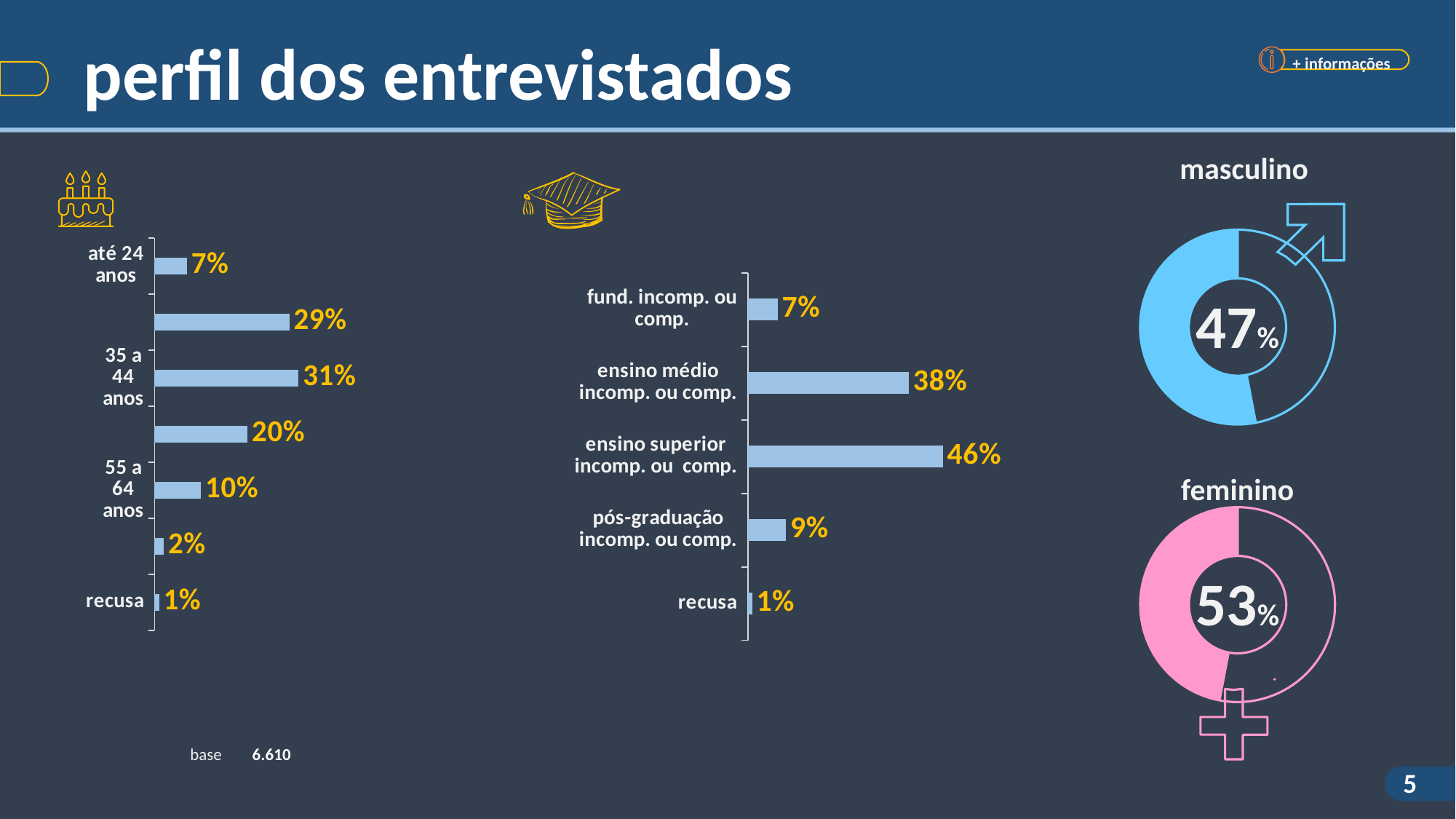
In the education chart in the middle, which category has the highest value? ensino superior incomp. ou comp. In the education chart in the middle, what is the difference between 'ensino médio incomp. ou comp.' and 'pós-graduação incomp. ou comp.'? 29% In the age chart on the left, what is the value for '55 a 64 anos'? 10% In the age chart on the left, what is the value for '35 a 44 anos'? 31% In the age chart on the left, what is the difference between '35 a 44 anos' and '55 a 64 anos'? 21% In the education chart in the middle, what is the value for 'ensino superior incomp. ou comp.'? 46% In the age chart on the left, what is the value for 'até 24 anos'? 7% In the age chart on the left, how many bars are plotted? 7 What kind of chart is the education chart in the middle of the slide? bar chart In the gender charts on the right, what share is 'feminino'? 53% In the education chart in the middle, which category has the lowest value? recusa In the education chart in the middle, which is larger: 'fund. incomp. ou comp.' or 'pós-graduação incomp. ou comp.'? pós-graduação incomp. ou comp.